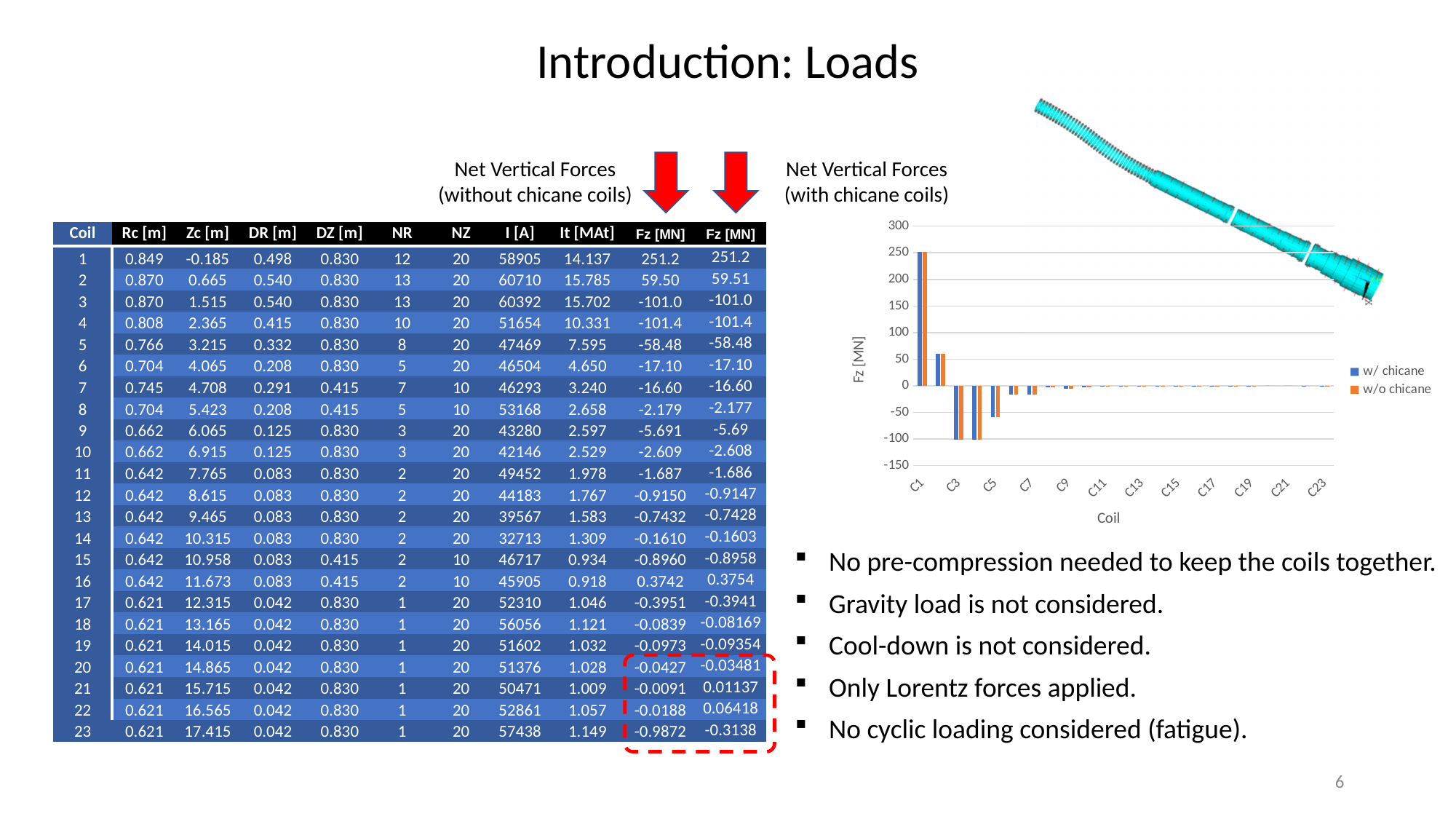
Which is larger in the chart, the 'w/ chicane' value for C1 or for C2? C1 Is the 'w/ chicane' value for C3 greater or less than -50? less Is the 'w/o chicane' value for C2 greater or less than 50? greater What kind of chart is shown on the slide? bar chart How many series does the chart's legend list? 2 What is the label on the chart's vertical axis? Fz [MN] Is the 'w/ chicane' value for C1 greater or less than 200? greater Which coil has the highest Fz value in the chart? C1 Moving from C7 to C23 along the x axis, do the bars get closer to zero or further from zero? closer to zero Which colour represents the 'w/o chicane' series in the chart? orange